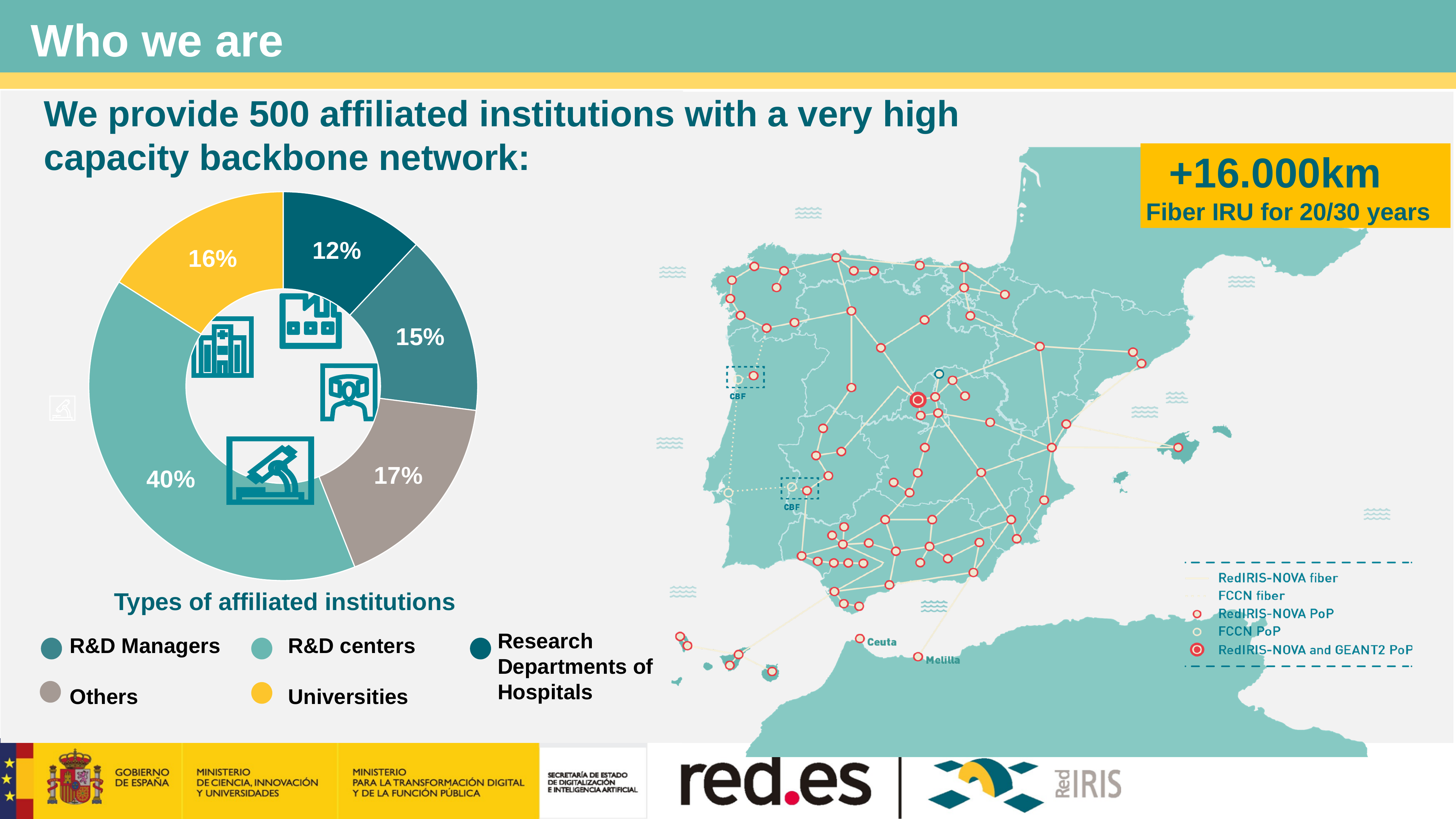
What share of affiliated institutions are R&D centers? 40% How many categories does the donut chart of affiliated institutions show? 5 How many percentage points larger is the R&D centers share than the Universities share? 24 What share of affiliated institutions fall under Others? 17% What share of affiliated institutions are R&D Managers? 15% Which has a larger share: Others or R&D Managers? Others What is the title of the donut chart? Types of affiliated institutions Which type of affiliated institution has the largest share? R&D centers What type of chart is used to show the types of affiliated institutions? Donut (pie) chart Which type of affiliated institution has the smallest share? Research Departments of Hospitals What share of affiliated institutions are Research Departments of Hospitals? 12% What share of affiliated institutions are Universities? 16%